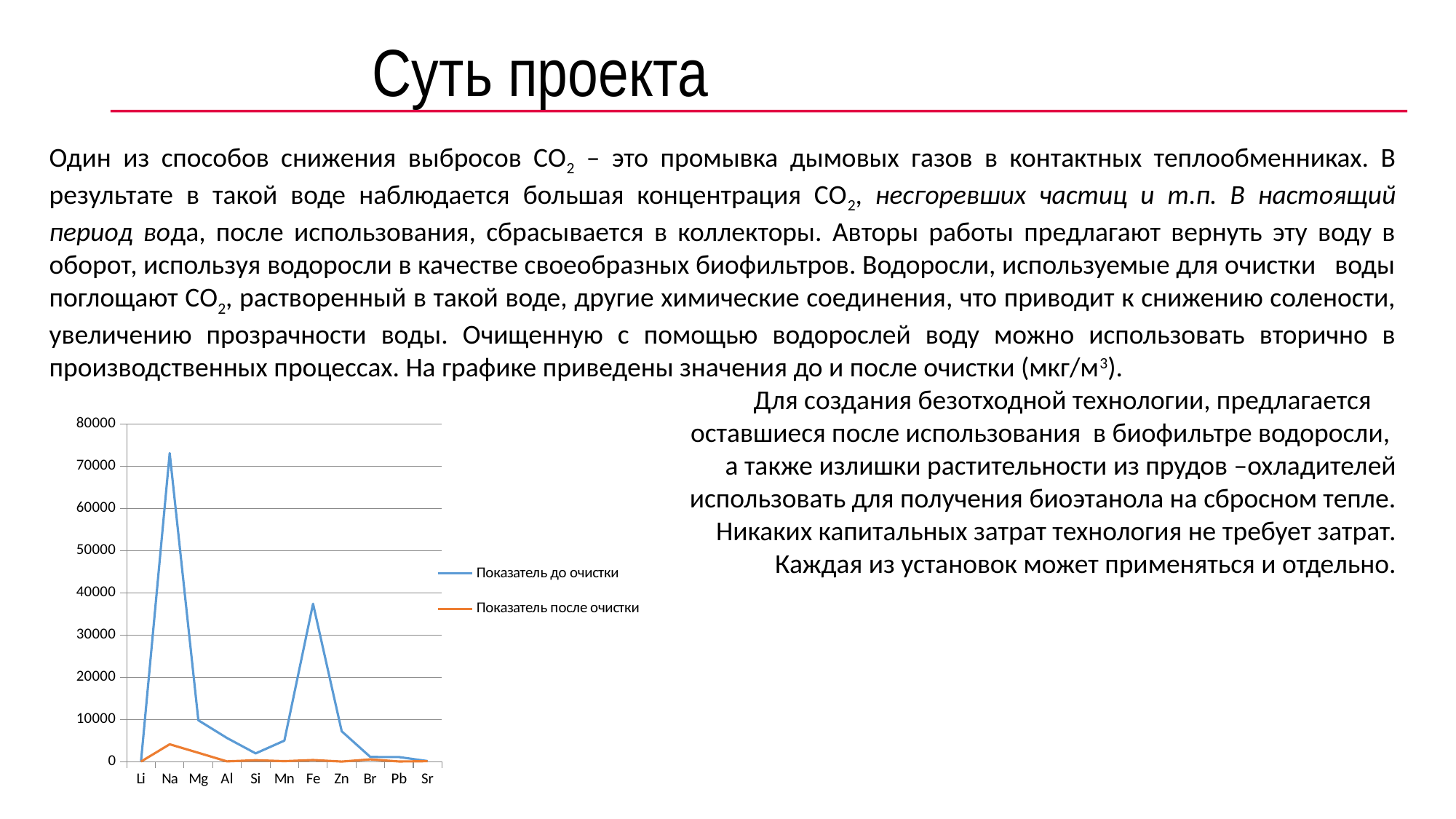
Is the value for Na in the series 'Показатель после очистки' greater or less than 10000? less How many series does the chart legend list? 2 What is the first category on the x axis of the chart? Li Is the value for Fe in the series 'Показатель до очистки' greater or less than 40000? less How many categories are shown on the x axis of the chart? 11 For Na, which series has the larger value: 'Показатель до очистки' or 'Показатель после очистки'? Показатель до очистки Which series is drawn in orange in the chart? Показатель после очистки In the series 'Показатель до очистки', which is larger: the value for Na or the value for Fe? Na Which category has the highest value for the series 'Показатель до очистки'? Na Is the value for Na in the series 'Показатель до очистки' greater or less than 70000? greater What kind of chart is shown on the slide? line chart